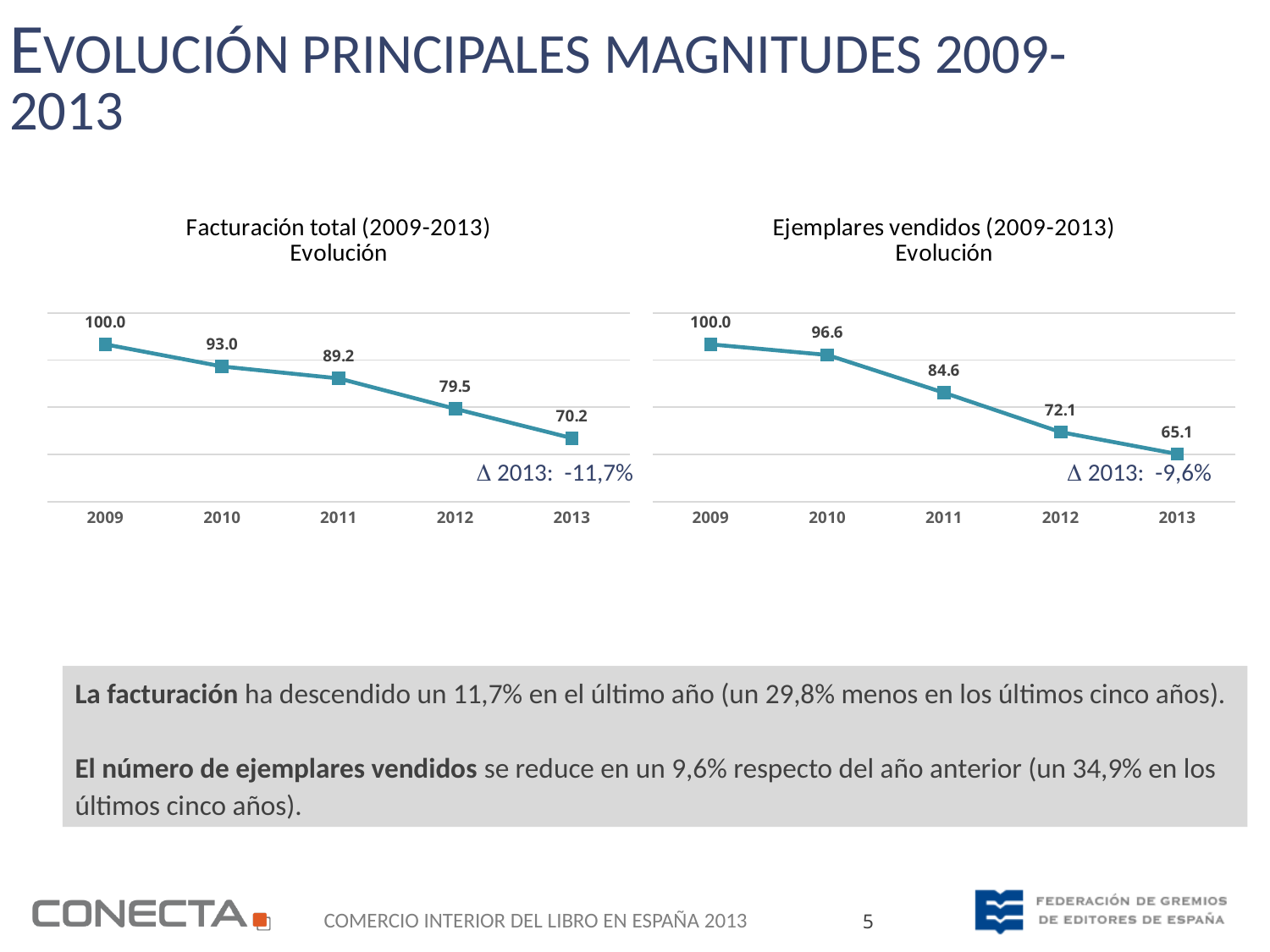
How many data points are plotted in the 'Facturación total (2009-2013) Evolución' chart? 5 In the 'Ejemplares vendidos (2009-2013) Evolución' chart, which year has the highest value? 2009 In the 'Facturación total (2009-2013) Evolución' chart, what is the difference between the 2012 and 2013 values? 9.3 In the 'Ejemplares vendidos (2009-2013) Evolución' chart, do the values rise or fall from 2009 to 2013? Fall What change for 2013 is annotated on the 'Ejemplares vendidos (2009-2013) Evolución' chart? Δ 2013: -9,6% In the 'Facturación total (2009-2013) Evolución' chart, what is the value for 2011? 89.2 In the 'Ejemplares vendidos (2009-2013) Evolución' chart, what is the value for 2012? 72.1 In the 'Ejemplares vendidos (2009-2013) Evolución' chart, what is the difference between the 2010 and 2011 values? 12.0 Which is larger: the 2013 value in the 'Facturación total' chart or the 2013 value in the 'Ejemplares vendidos' chart? Facturación total (70.2) In the 'Facturación total (2009-2013) Evolución' chart, which year has the lowest value? 2013 What type of chart is the 'Ejemplares vendidos (2009-2013) Evolución' chart? Line chart What change for 2013 is annotated on the 'Facturación total (2009-2013) Evolución' chart? Δ 2013: -11,7%